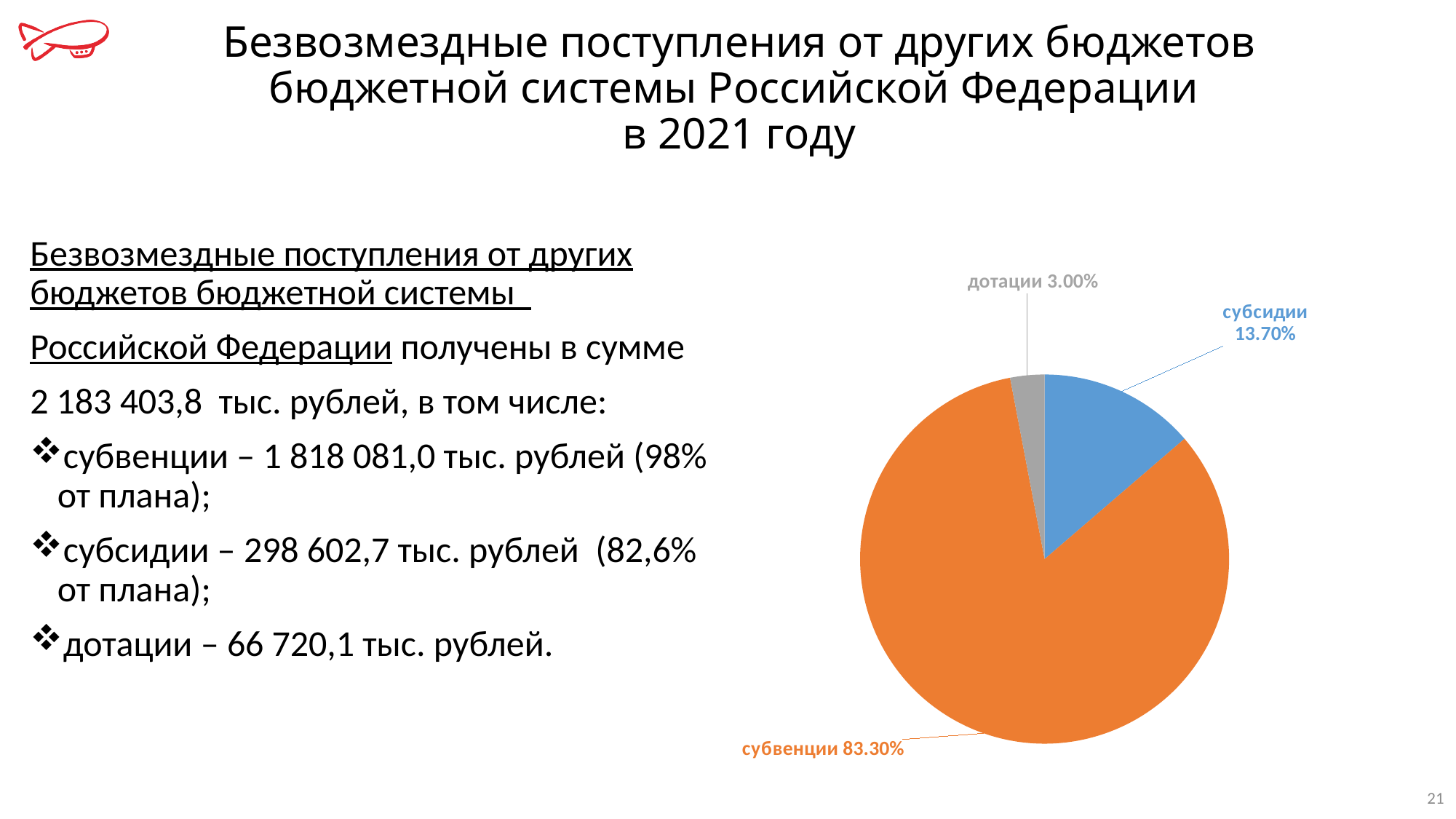
What is the difference in percentage points between the субсидии and дотации slices? 10.70% What share of the pie does субсидии represent? 13.70% Which is larger in the pie chart, субсидии or дотации? субсидии Which slice of the pie chart is the largest? субвенции How many slices does the pie chart have? 3 Which slice of the pie chart is the smallest? дотации What share of the pie does субвенции represent? 83.30% What colour is the субвенции slice in the pie chart? orange What kind of chart is shown on the slide? pie chart What is the difference in percentage points between the субвенции and субсидии slices? 69.60% What colour is the дотации slice in the pie chart? grey What share of the pie does дотации represent? 3.00%